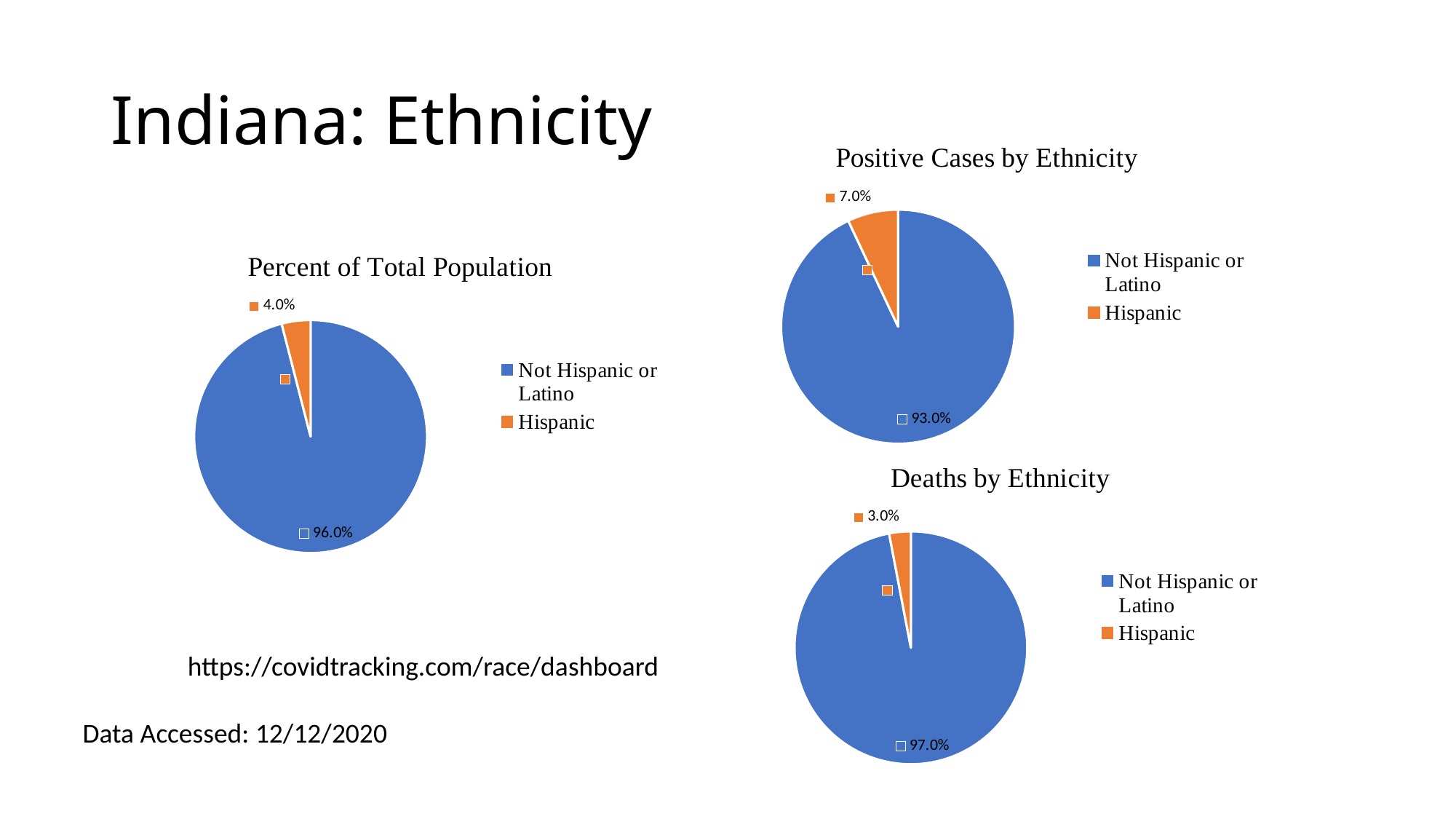
In the 'Positive Cases by Ethnicity' chart, what share of the pie is Not Hispanic or Latino? 93.0% In the 'Deaths by Ethnicity' chart, which category has the smallest slice? Hispanic What is the difference between the Hispanic share in the 'Positive Cases by Ethnicity' chart and the Hispanic share in the 'Percent of Total Population' chart? 3.0% In the 'Percent of Total Population' chart, what share of the pie is Not Hispanic or Latino? 96.0% In the 'Positive Cases by Ethnicity' chart, which category has the largest slice? Not Hispanic or Latino What type of chart is 'Deaths by Ethnicity'? Pie chart Is the Hispanic share larger in the 'Positive Cases by Ethnicity' chart or in the 'Deaths by Ethnicity' chart? Positive Cases by Ethnicity In the 'Deaths by Ethnicity' chart, what share of the pie is Hispanic? 3.0% How many categories does the legend of the 'Percent of Total Population' chart list? 2 In the 'Positive Cases by Ethnicity' chart, what share of the pie is Hispanic? 7.0% In the 'Percent of Total Population' chart, what share of the pie is Hispanic? 4.0% In the 'Deaths by Ethnicity' chart, what share of the pie is Not Hispanic or Latino? 97.0%